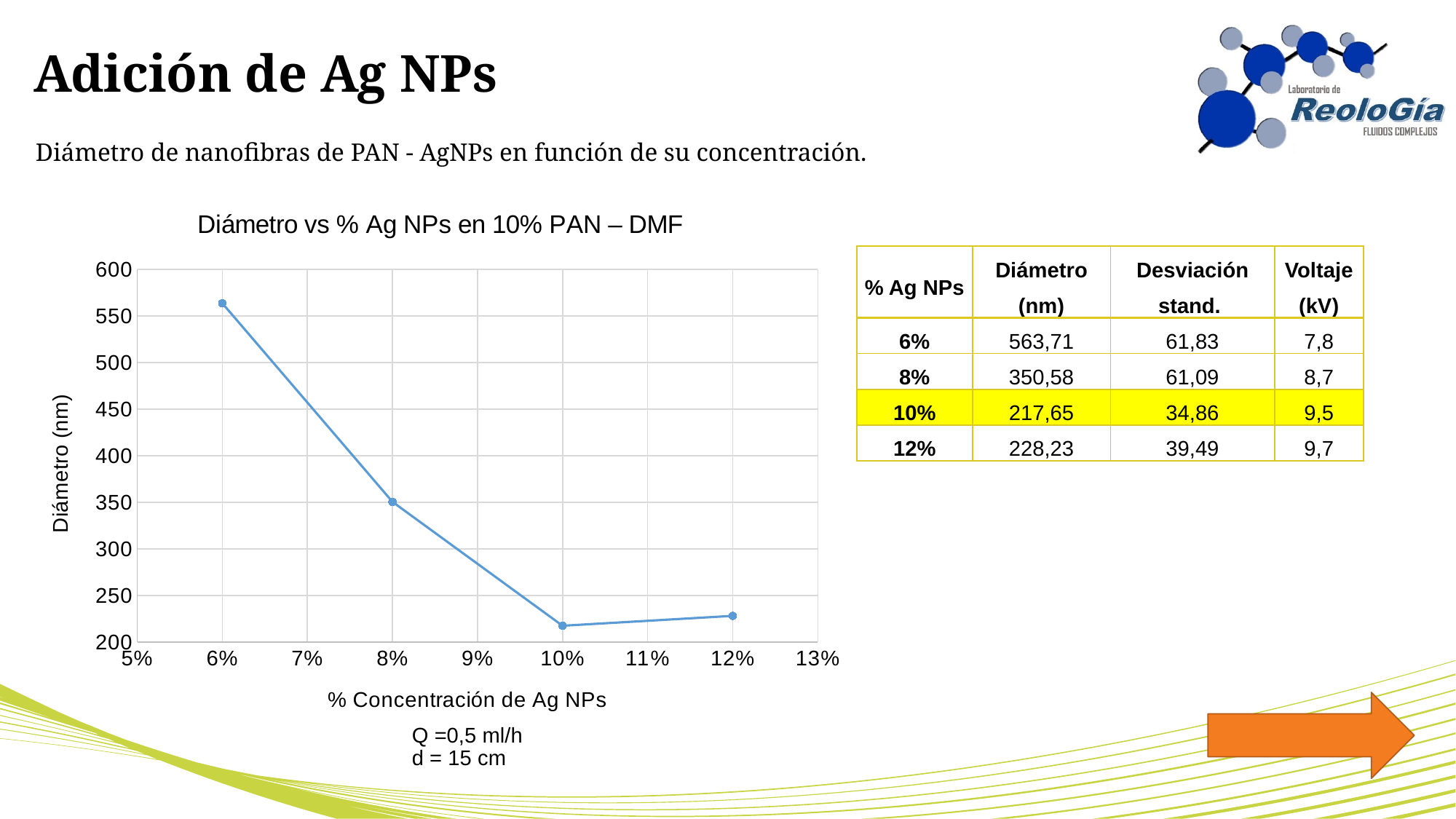
What is the title of the chart? Diámetro vs % Ag NPs en 10% PAN – DMF What kind of chart is shown on the slide? line chart How many data points are plotted on the chart? 4 What is the label of the y axis of the chart? Diámetro (nm) Is the diameter at 8% Ag NPs greater or less than 400 nm? less Does the diameter generally rise or fall as the Ag NPs concentration increases from 6% to 10%? fall Which has a larger diameter, 6% Ag NPs or 8% Ag NPs? 6% What is the diameter (nm) at 6% Ag NPs? 563,71 At which Ag NPs concentration is the diameter highest? 6% What is the diameter (nm) at 12% Ag NPs? 228,23 At which Ag NPs concentration is the diameter lowest? 10% What is the diameter (nm) at 8% Ag NPs? 350,58